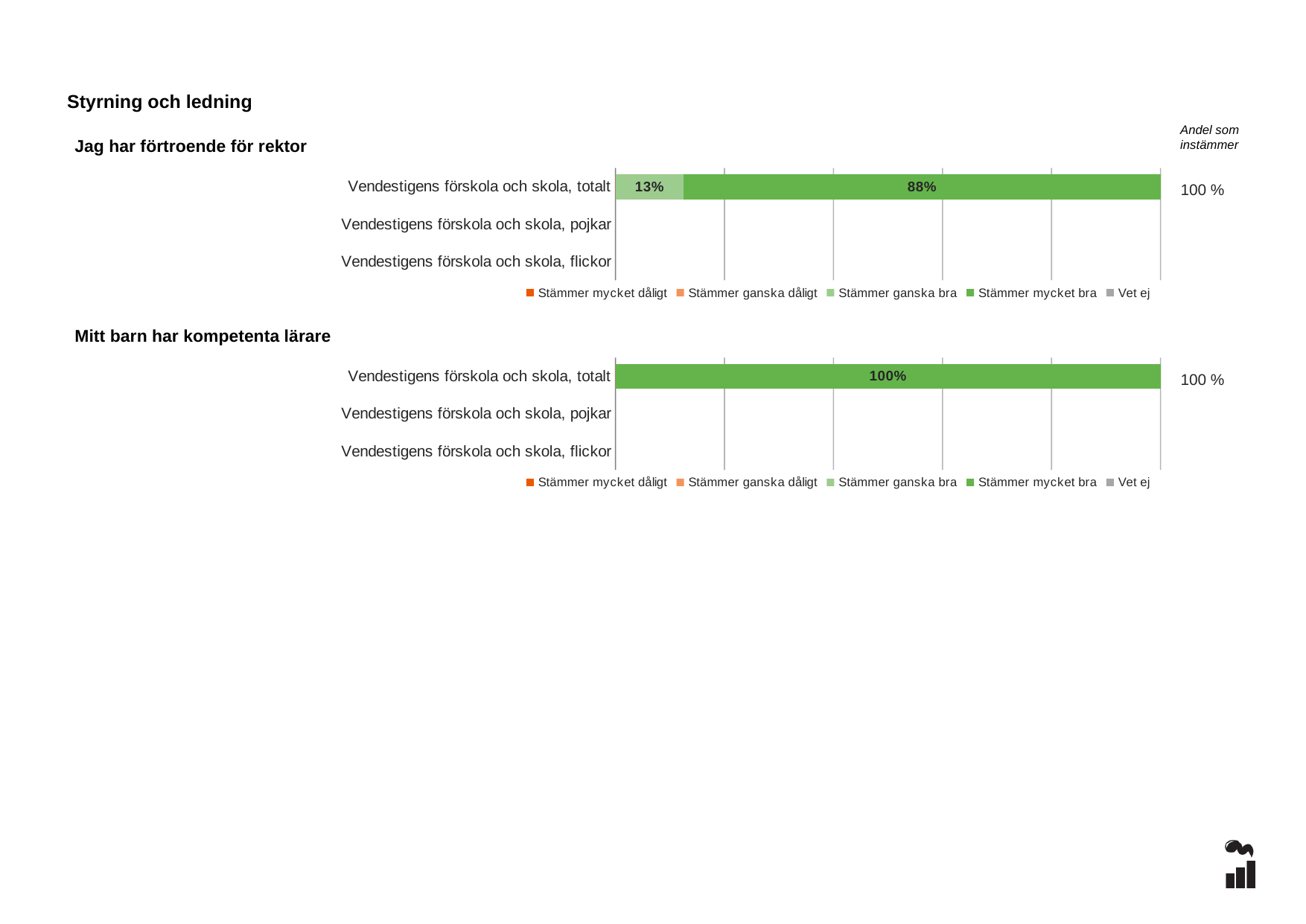
What is the title of the upper chart on the slide? Jag har förtroende för rektor What kind of chart is 'Mitt barn har kompetenta lärare'? Stacked horizontal bar chart In the chart 'Mitt barn har kompetenta lärare', what percentage of 'Vendestigens förskola och skola, totalt' answered 'Stämmer mycket bra'? 100% In the chart 'Mitt barn har kompetenta lärare', which legend entry is shown in orange-red? Stämmer mycket dåligt In the chart 'Jag har förtroende för rektor', what is the difference in percentage points between 'Stämmer mycket bra' and 'Stämmer ganska bra' for 'Vendestigens förskola och skola, totalt'? 75 How many series does the legend of the chart 'Mitt barn har kompetenta lärare' list? 5 How many categories are listed on the y axis of the chart 'Jag har förtroende för rektor'? 3 In the chart 'Jag har förtroende för rektor', what percentage of 'Vendestigens förskola och skola, totalt' answered 'Stämmer mycket bra'? 88% In the chart 'Jag har förtroende för rektor', what percentage of 'Vendestigens förskola och skola, totalt' answered 'Stämmer ganska bra'? 13% In the chart 'Jag har förtroende för rektor', is the 'Stämmer mycket bra' value for 'Vendestigens förskola och skola, totalt' greater or less than 50%? greater In the chart 'Jag har förtroende för rektor', which is larger for 'Vendestigens förskola och skola, totalt': 'Stämmer ganska bra' or 'Stämmer mycket bra'? Stämmer mycket bra In the chart 'Jag har förtroende för rektor', what is the 'Andel som instämmer' value shown for 'Vendestigens förskola och skola, totalt'? 100 %